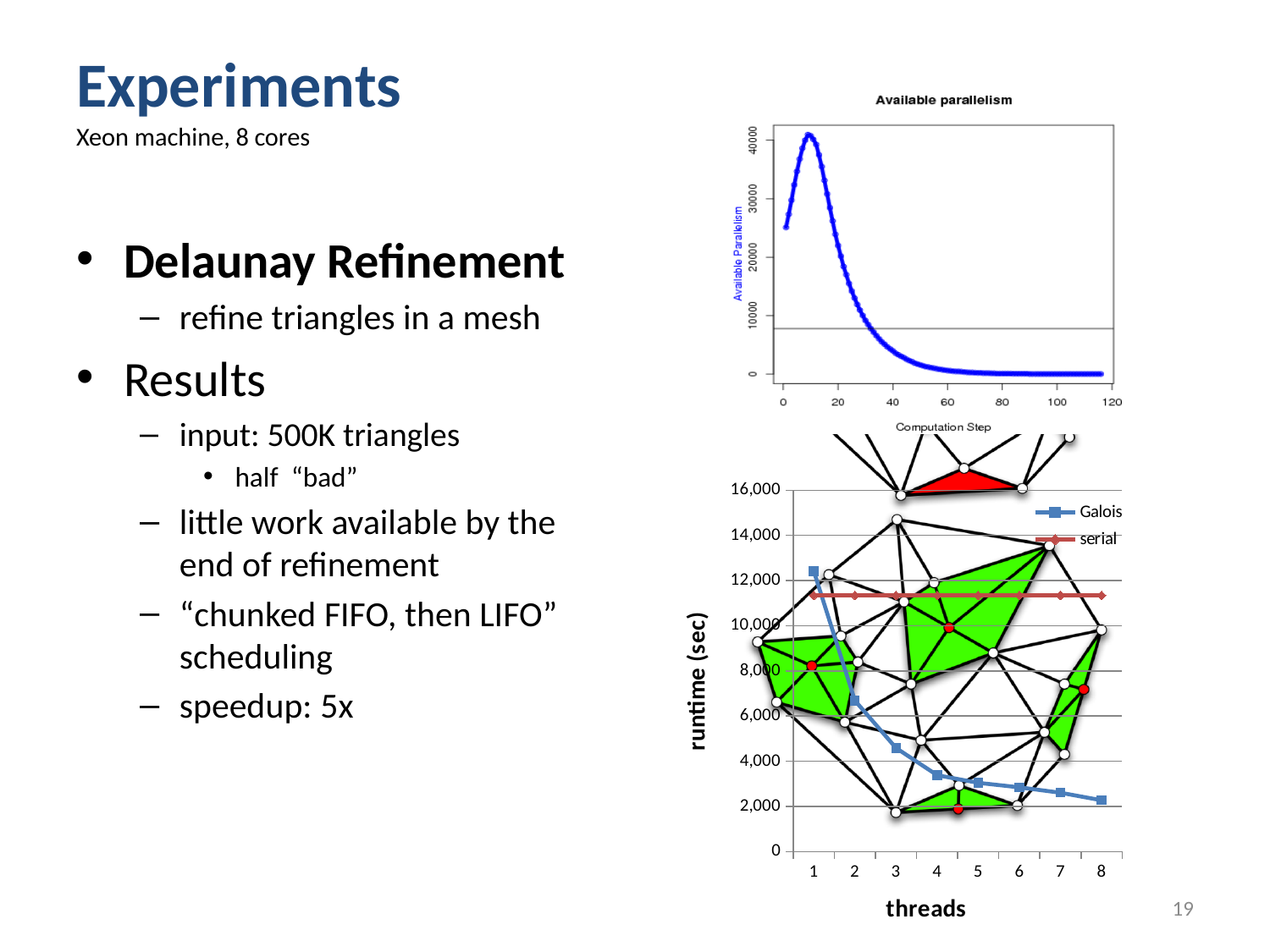
In the runtime versus threads chart, is the Galois runtime at 8 threads greater or less than 4,000? less In the runtime versus threads chart, is the Galois runtime at 1 thread greater or less than 10,000? greater What kind of chart is the bottom-right chart of runtime versus threads? line chart In the 'Available parallelism' chart, is the available parallelism at computation step 100 greater or less than 10000? less In the runtime versus threads chart, does the Galois runtime rise or fall as the number of threads increases? fall In the runtime versus threads chart, at 8 threads, which series has the larger runtime, Galois or serial? serial In the runtime versus threads chart, how many thread counts are plotted on the x axis? 8 What kind of chart is the top-right 'Available parallelism' chart? line chart In the runtime versus threads chart, at which number of threads is the Galois runtime lowest? 8 In the runtime versus threads chart, what are the two series named in the legend? Galois and serial In the runtime versus threads chart, how many series does the legend list? 2